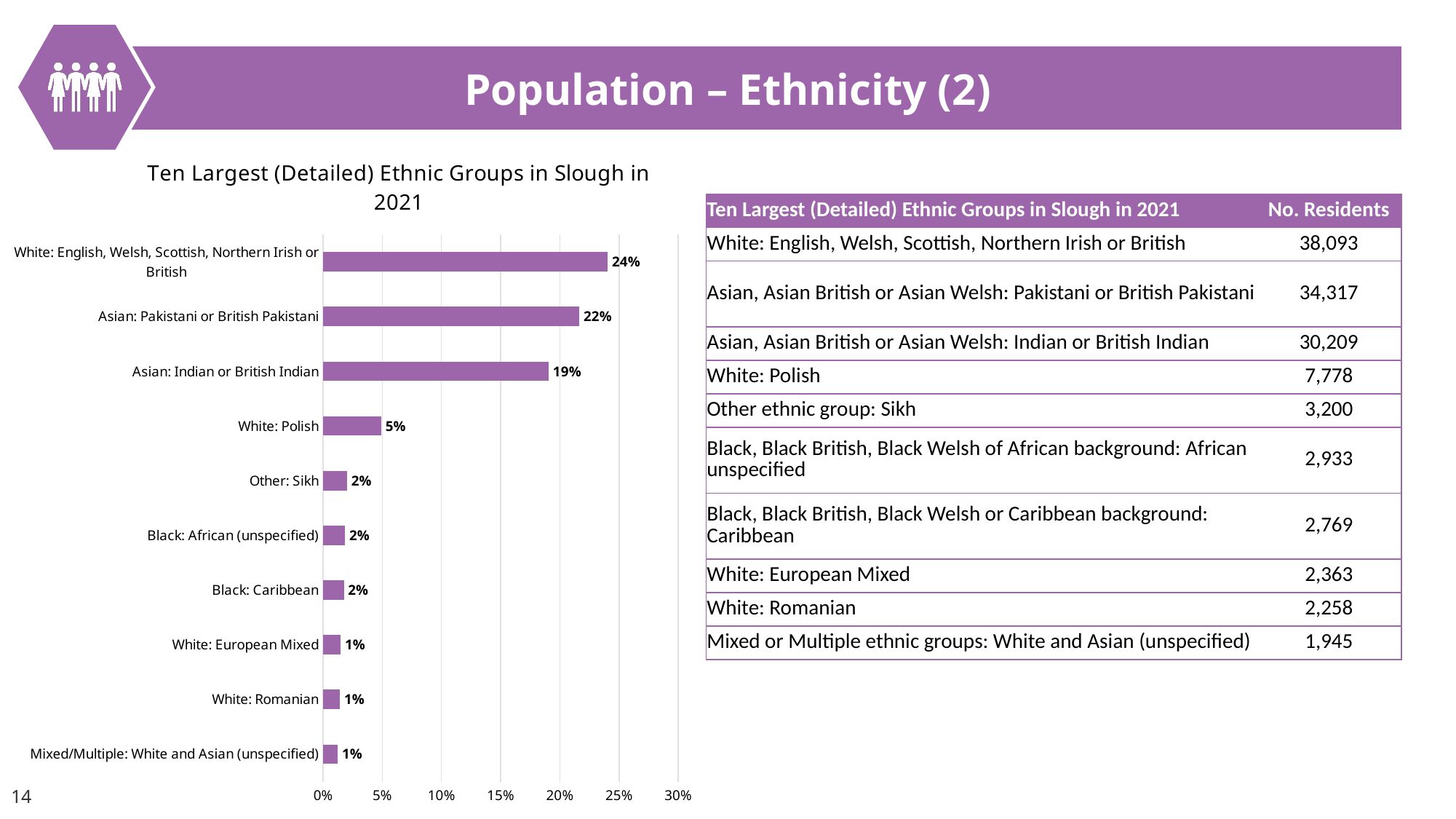
What kind of chart is shown on the slide? Bar chart What is the difference in percentage points between White: English, Welsh, Scottish, Northern Irish or British and Asian: Pakistani or British Pakistani? 2% What is the difference in percentage points between Asian: Indian or British Indian and White: Polish? 14% How many ethnic groups are shown in the chart? 10 What percentage does the chart show for Asian: Pakistani or British Pakistani? 22% Is the value for Asian: Indian or British Indian greater or less than 15%? greater What percentage does the chart show for White: Polish? 5% Which ethnic group has the highest percentage in the chart? White: English, Welsh, Scottish, Northern Irish or British What is the maximum value shown on the chart's horizontal axis? 30% What is the title of the chart? Ten Largest (Detailed) Ethnic Groups in Slough in 2021 What percentage does the chart show for Asian: Indian or British Indian? 19% Which is larger, the percentage for White: Polish or the percentage for Other: Sikh? White: Polish